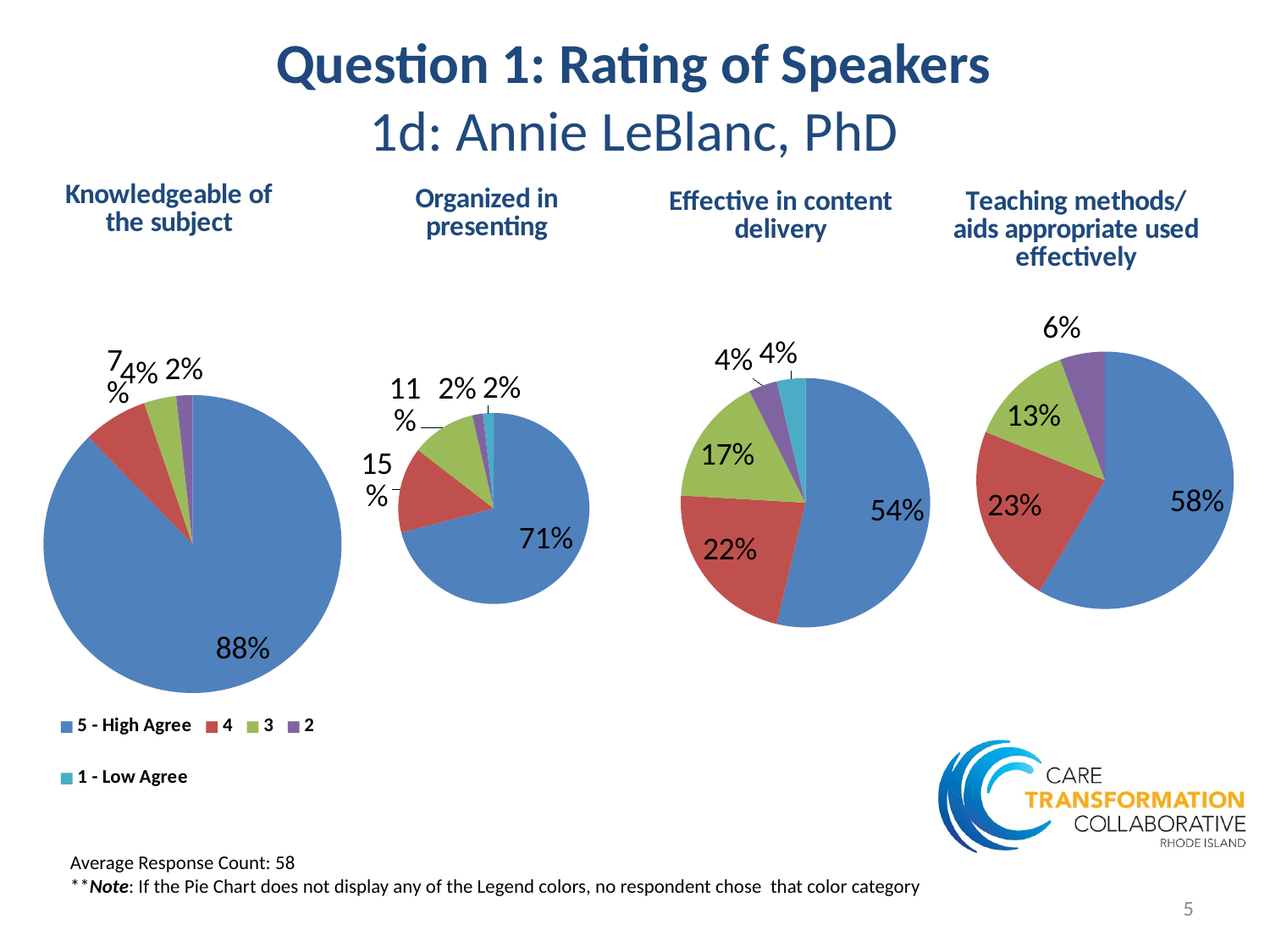
In the 'Knowledgeable of the subject' pie chart, what share of respondents chose 5 - High Agree? 88% What is the average response count stated on the slide? 58 In the 'Organized in presenting' pie chart, what share of respondents chose 4? 15% What type of chart is used to show the ratings on this slide? Pie chart How many slices does the 'Effective in content delivery' pie chart have? 5 In the 'Organized in presenting' pie chart, what is the difference between the 5 - High Agree share and the 4 share? 56% How many rating categories does the legend list? 5 In the 'Teaching methods/aids appropriate used effectively' pie chart, which rating category has the smallest slice? 2 Is the 5 - High Agree share larger in the 'Knowledgeable of the subject' chart or in the 'Effective in content delivery' chart? Knowledgeable of the subject In the 'Effective in content delivery' pie chart, which rating category has the largest slice? 5 - High Agree In the 'Effective in content delivery' pie chart, what share of respondents chose 3? 17% In the 'Teaching methods/aids appropriate used effectively' pie chart, what share of respondents chose 5 - High Agree? 58%